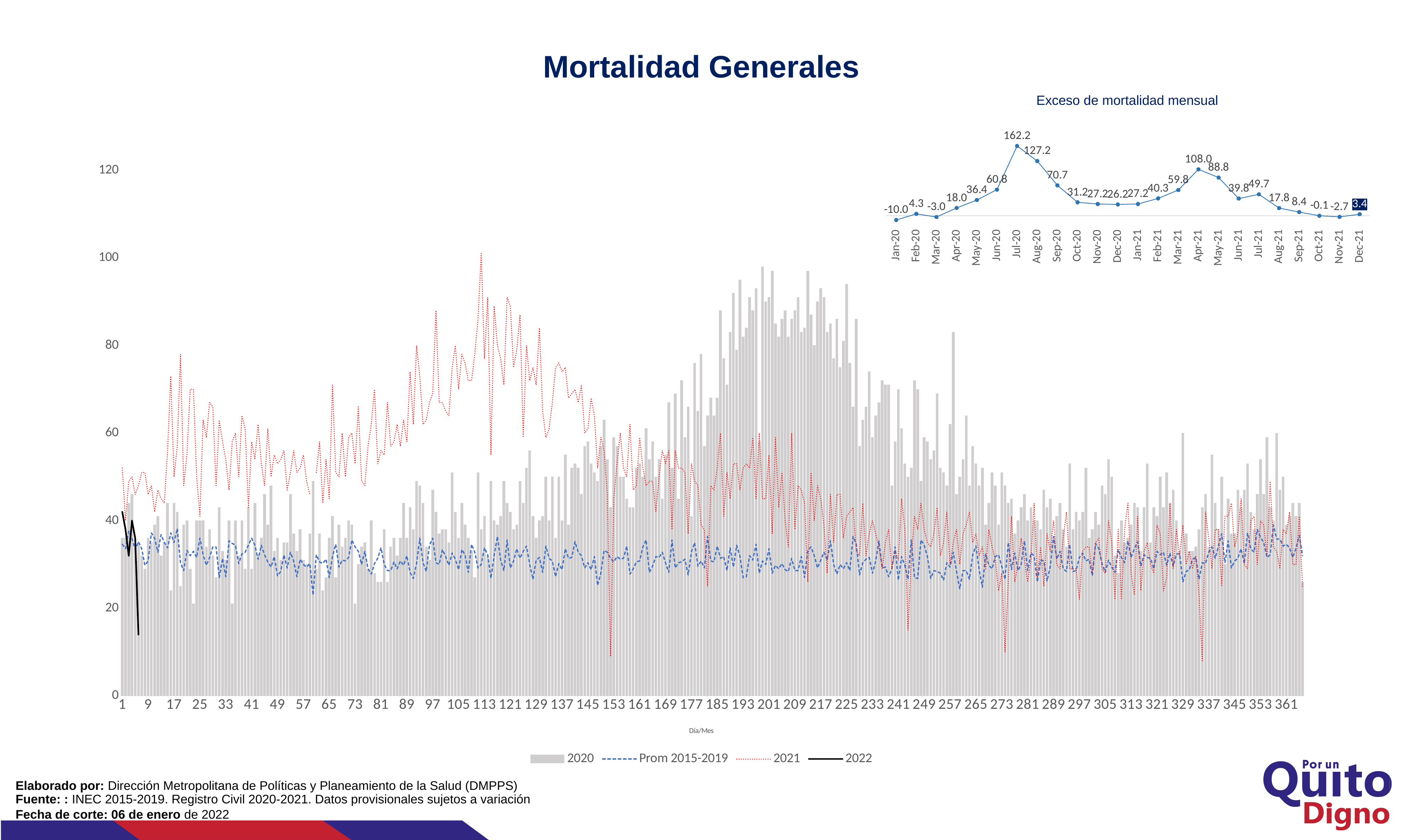
In the 'Exceso de mortalidad mensual' chart, what is the value for Jan-20? -10.0 In the 'Exceso de mortalidad mensual' chart, which is larger, the value for May-21 or the value for Sep-20? May-21 In the 'Exceso de mortalidad mensual' chart, which month has the highest value? Jul-20 In the 'Mortalidad Generales' chart, which series is drawn as grey bars? 2020 In the 'Mortalidad Generales' chart, is the peak of the 2021 line around day 113 greater or less than 80? greater In the 'Exceso de mortalidad mensual' chart, what is the value for Apr-21? 108.0 In the 'Exceso de mortalidad mensual' chart, what is the difference between the values for Jul-20 and Aug-20? 35.0 In the 'Exceso de mortalidad mensual' chart, what is the value for Dec-21? 3.4 How many monthly data points are plotted in the 'Exceso de mortalidad mensual' chart? 24 In the 'Exceso de mortalidad mensual' chart, which month has the lowest value? Jan-20 In the 'Exceso de mortalidad mensual' chart, what is the value for Jul-20? 162.2 How many series does the legend of the 'Mortalidad Generales' chart list? 4